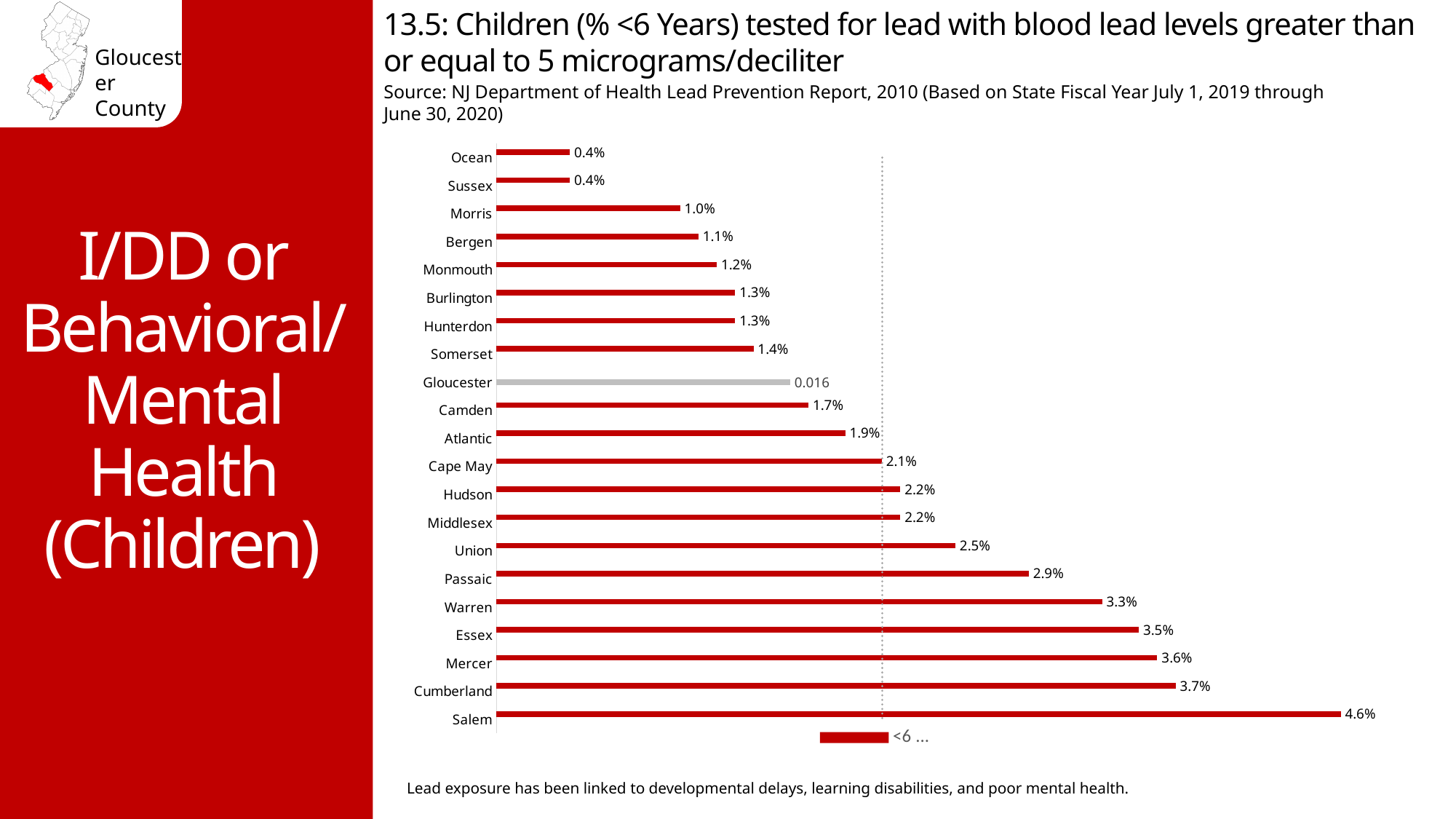
What is the difference between the values for Salem and Cumberland? 0.9% What type of chart is shown on the slide? bar chart What label is shown for the Gloucester bar? 0.016 What colour is the Gloucester bar compared with the other bars? grey (others are red) What is the value shown for Camden? 1.7% What is the value shown for Salem? 4.6% Which is larger, the value for Passaic or the value for Union? Passaic How many counties are shown in the chart? 21 Which county has the lowest value, Ocean or Morris? Ocean Which county has the highest value in the chart? Salem What is the difference between the values for Mercer and Camden? 1.9% What is the value shown for Warren? 3.3%